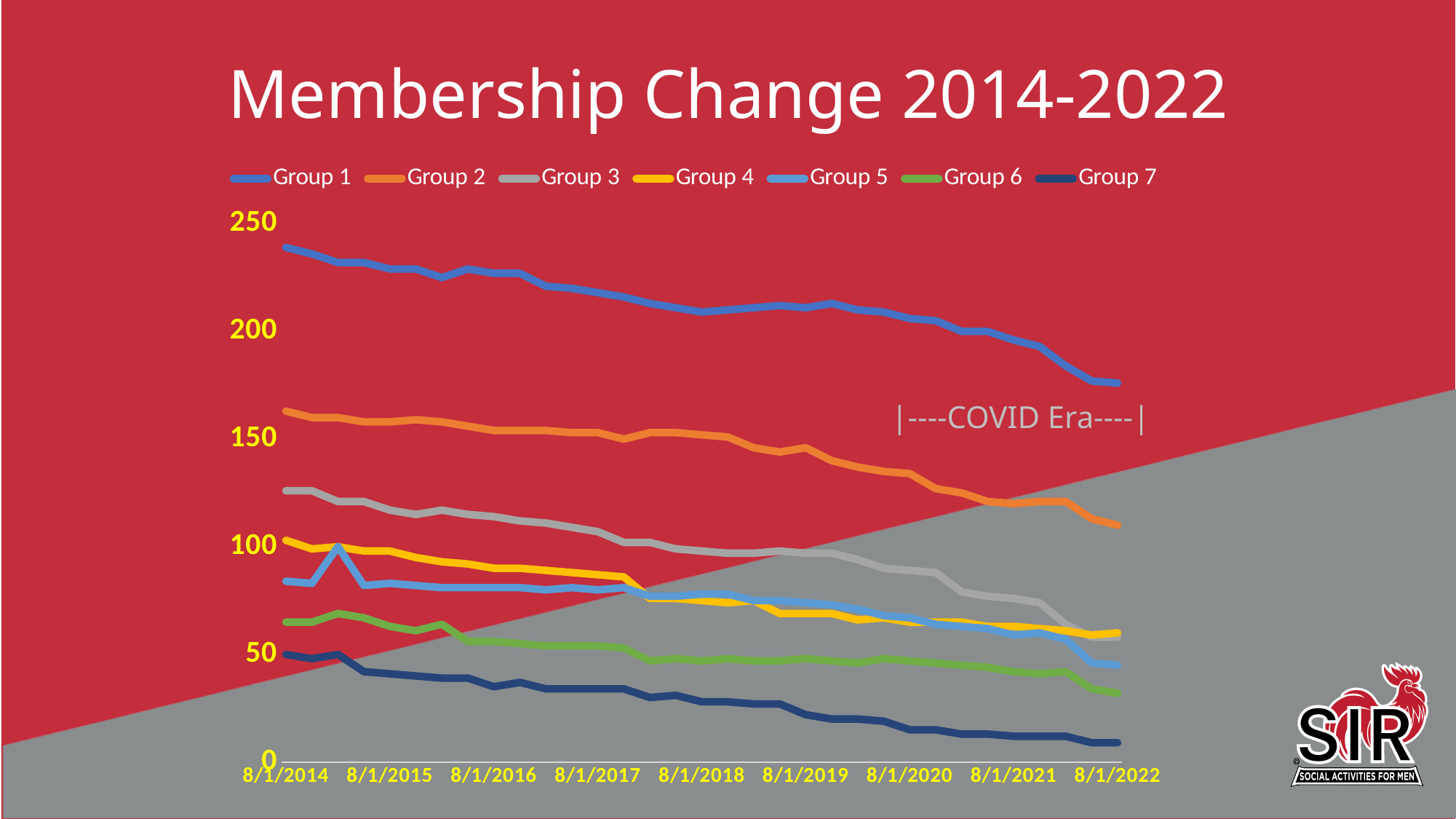
Which group has the lowest membership across the whole period? Group 7 At 8/1/2022, which is larger: Group 1 or Group 2? Group 1 What kind of chart is shown on the slide? line chart Which group has the highest membership across the whole period? Group 1 Is the value for Group 1 at 8/1/2014 greater or less than 200? greater Is the value for Group 1 at 8/1/2022 greater or less than 200? less Does the membership of Group 1 rise or fall from 8/1/2014 to 8/1/2022? fall How many date labels are shown on the x axis? 9 What is the title of the chart? Membership Change 2014-2022 How many series does the legend list? 7 Is the value for Group 2 at 8/1/2022 greater or less than 150? less